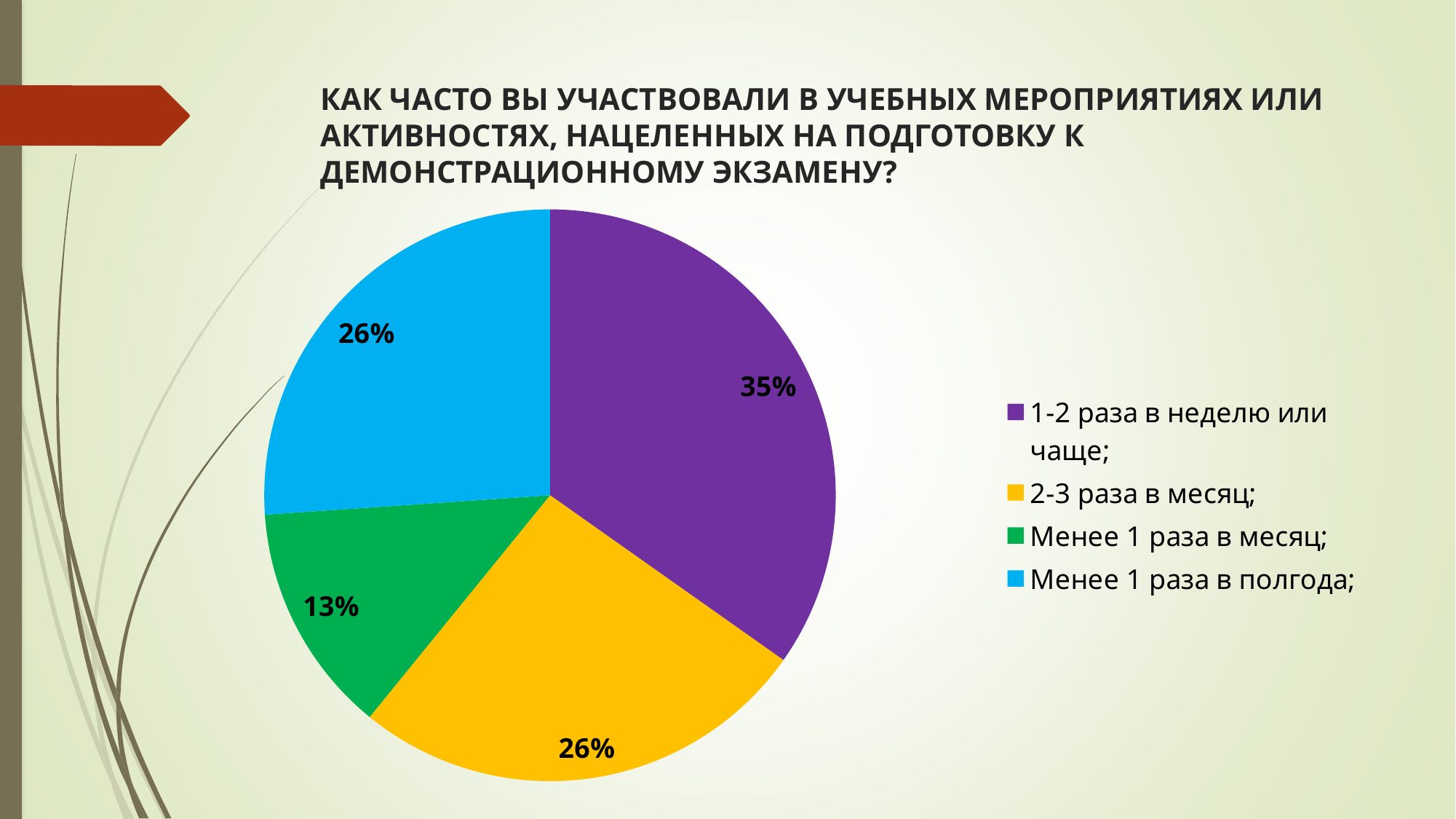
What share of the pie is labelled "Менее 1 раза в полгода"? 26% Which category has the largest slice of the pie? 1-2 раза в неделю или чаще Which category has the smallest slice of the pie? Менее 1 раза в месяц How many categories does the pie chart show? 4 What colour is the slice for "Менее 1 раза в полгода"? Blue What share of the pie is labelled "Менее 1 раза в месяц"? 13% Which is larger: the slice for "2-3 раза в месяц" or the slice for "Менее 1 раза в месяц"? 2-3 раза в месяц What kind of chart is shown on the slide? Pie chart What share of the pie is labelled "1-2 раза в неделю или чаще"? 35% What share of the pie is labelled "2-3 раза в месяц"? 26% Which category is shown in purple in the legend? 1-2 раза в неделю или чаще What is the difference in percentage points between "1-2 раза в неделю или чаще" and "Менее 1 раза в месяц"? 22